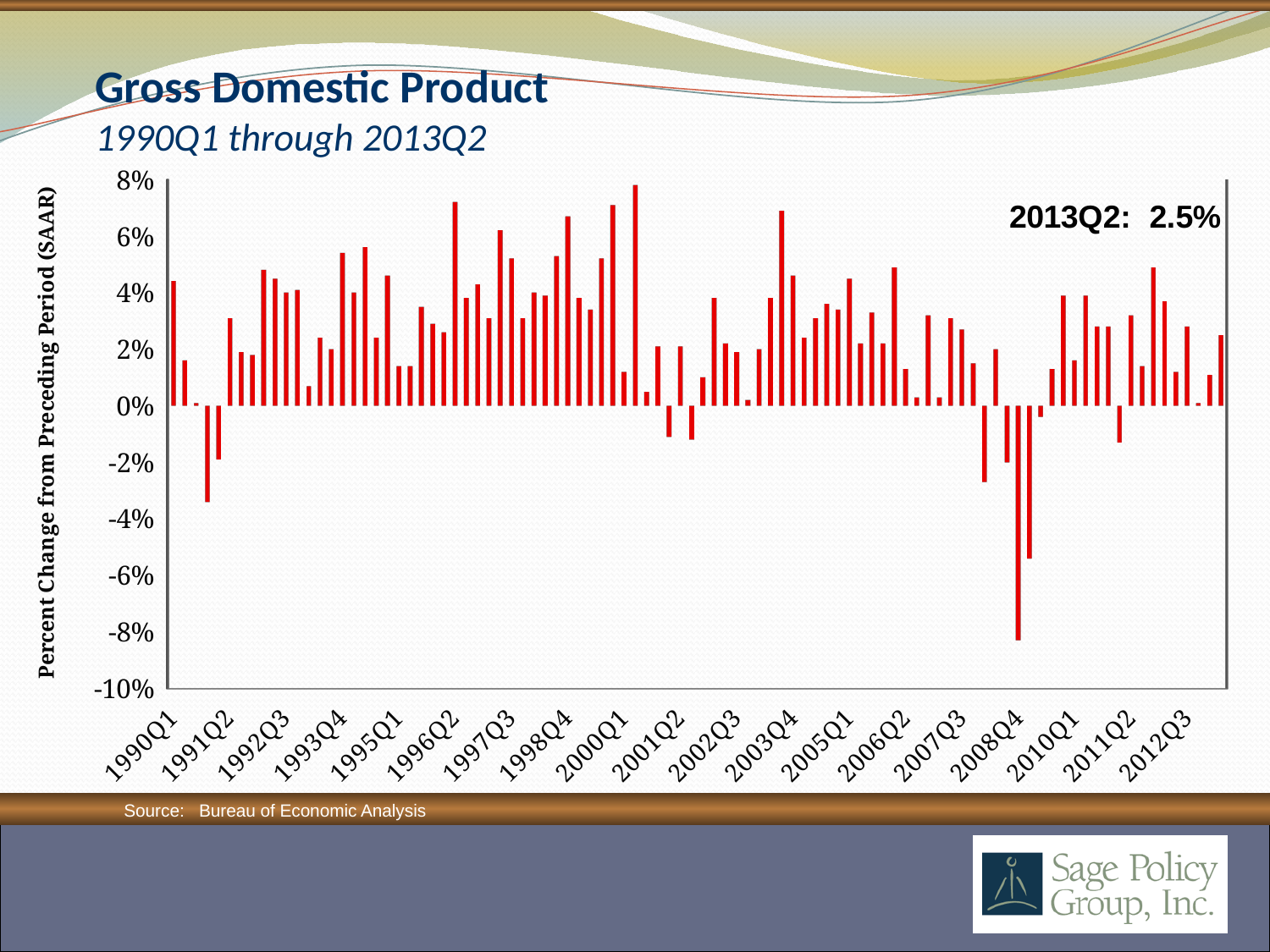
Which labeled quarter has the lowest value on the chart? 2008Q4 What is the value shown for 2013Q2? 2.5% Is the value for 1990Q1 greater or less than 2%? greater Which is larger, the value for 2013Q2 or the value for 2008Q4? 2013Q2 What is the title of the y axis? Percent Change from Preceding Period (SAAR) Is the value for 2013Q2 greater or less than 4%? less How many quarter labels are shown along the x axis? 19 Is the value for 2008Q4 greater or less than -6%? less What kind of chart is shown on the slide? bar chart What source is cited for the chart data? Bureau of Economic Analysis